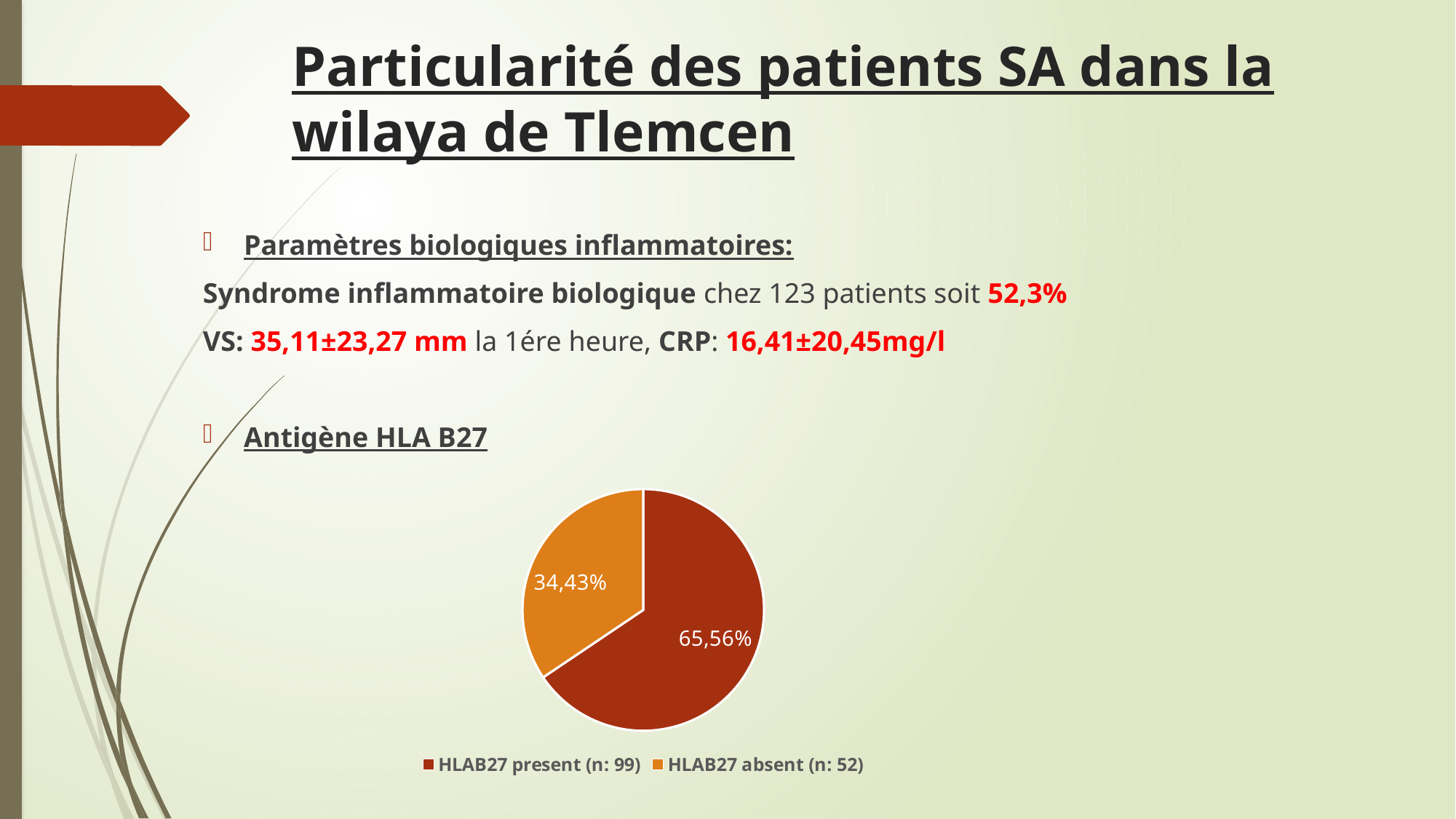
What percentage of the pie chart is labelled for HLAB27 present (n: 99)? 65,56% What percentage of the pie chart is labelled for HLAB27 absent (n: 52)? 34,43% How many slices does the pie chart have? 2 What colour is the HLAB27 absent slice in the pie chart? orange What kind of chart is shown on the slide? pie chart According to the legend, how many patients are in the HLAB27 present group? 99 Which is larger in the pie chart: HLAB27 present or HLAB27 absent? HLAB27 present Which slice of the pie chart is the smallest? HLAB27 absent (n: 52) How many entries does the legend of the pie chart list? 2 Which slice of the pie chart is the largest? HLAB27 present (n: 99) What is the difference in percentage points between the HLAB27 present slice and the HLAB27 absent slice? 31,13